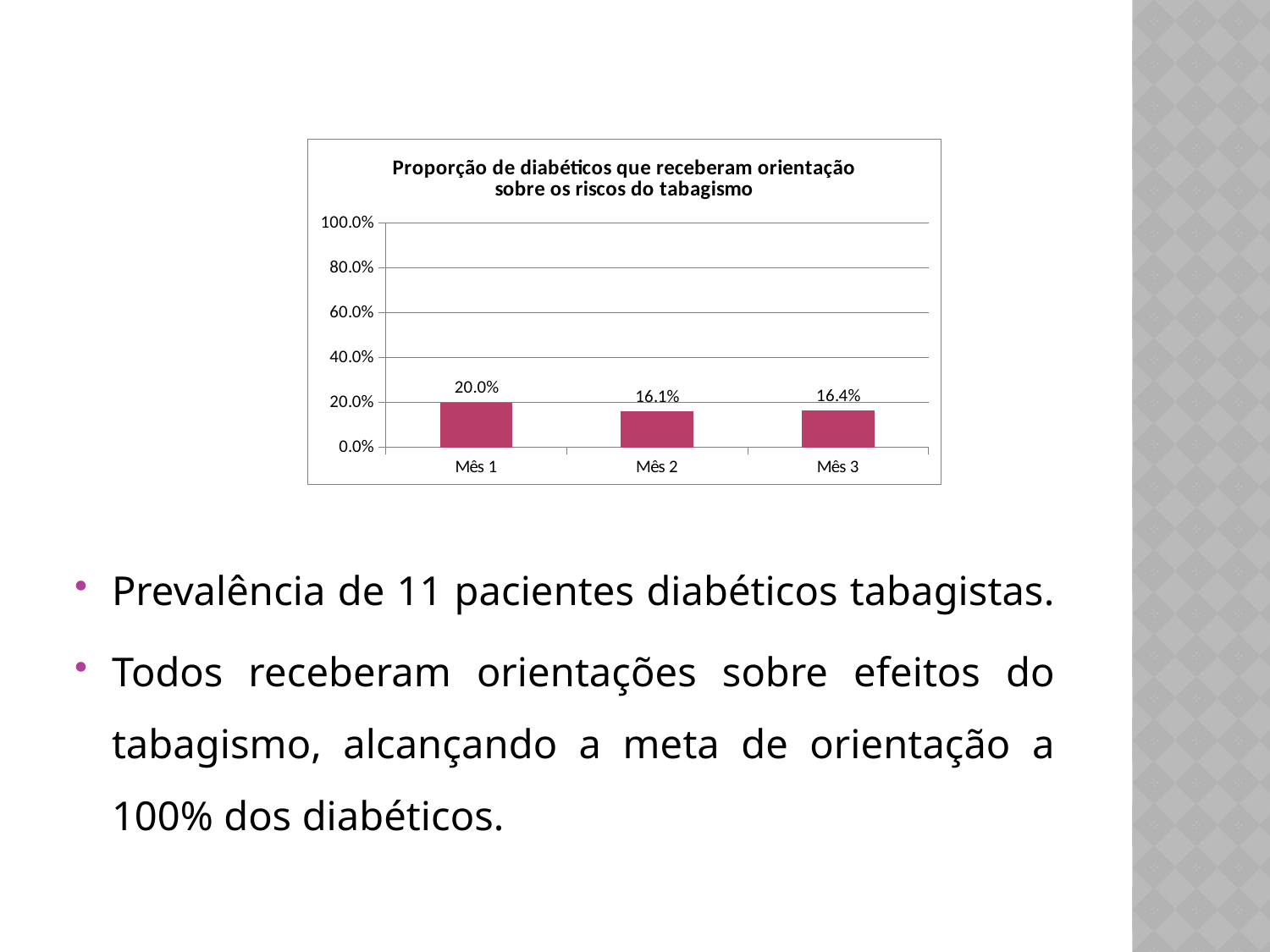
What kind of chart is shown on the slide? bar chart How many months are shown on the x axis? 3 What is the difference between the values for Mês 3 and Mês 2? 0.3% Which is larger, the value for Mês 1 or the value for Mês 3? Mês 1 Is the value for Mês 2 greater or less than 20.0%? less What is the difference between the values for Mês 1 and Mês 2? 3.9% Which month has the lowest value? Mês 2 What is the value for Mês 2? 16.1% Which month has the highest value? Mês 1 What is the value for Mês 1? 20.0% What is the value for Mês 3? 16.4% What is the title of the chart? Proporção de diabéticos que receberam orientação sobre os riscos do tabagismo